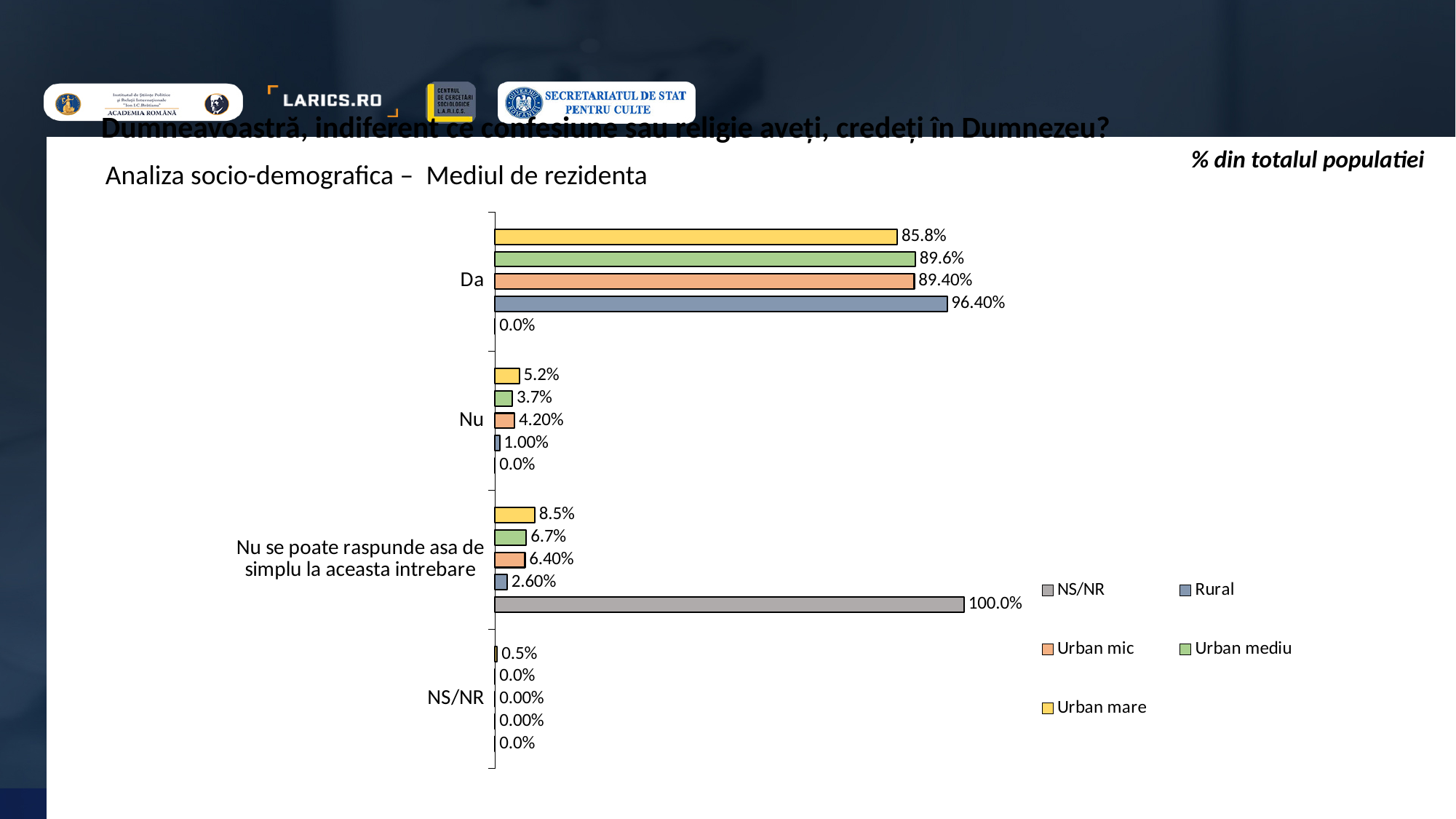
How many response categories are shown on the vertical axis? 4 What is the value for Urban mic in the "Nu se poate raspunde asa de simplu la aceasta intrebare" category? 6.40% What kind of chart is shown on the slide? Bar chart Which series has the lowest value in the "Nu" category, excluding the NS/NR series? Rural Which series has the highest value in the "Da" category? Rural What is the value for the NS/NR series in the "Nu se poate raspunde asa de simplu la aceasta intrebare" category? 100.0% What is the value for Urban mediu in the "Nu" category? 3.7% What is the value for Rural in the "Da" category? 96.40% What is the difference between the Rural and Urban mare values in the "Da" category? 10.6% How many series does the legend list? 5 In the "Nu" category, which is larger: Urban mare or Urban mic? Urban mare What is the value for Urban mare in the "Da" category? 85.8%